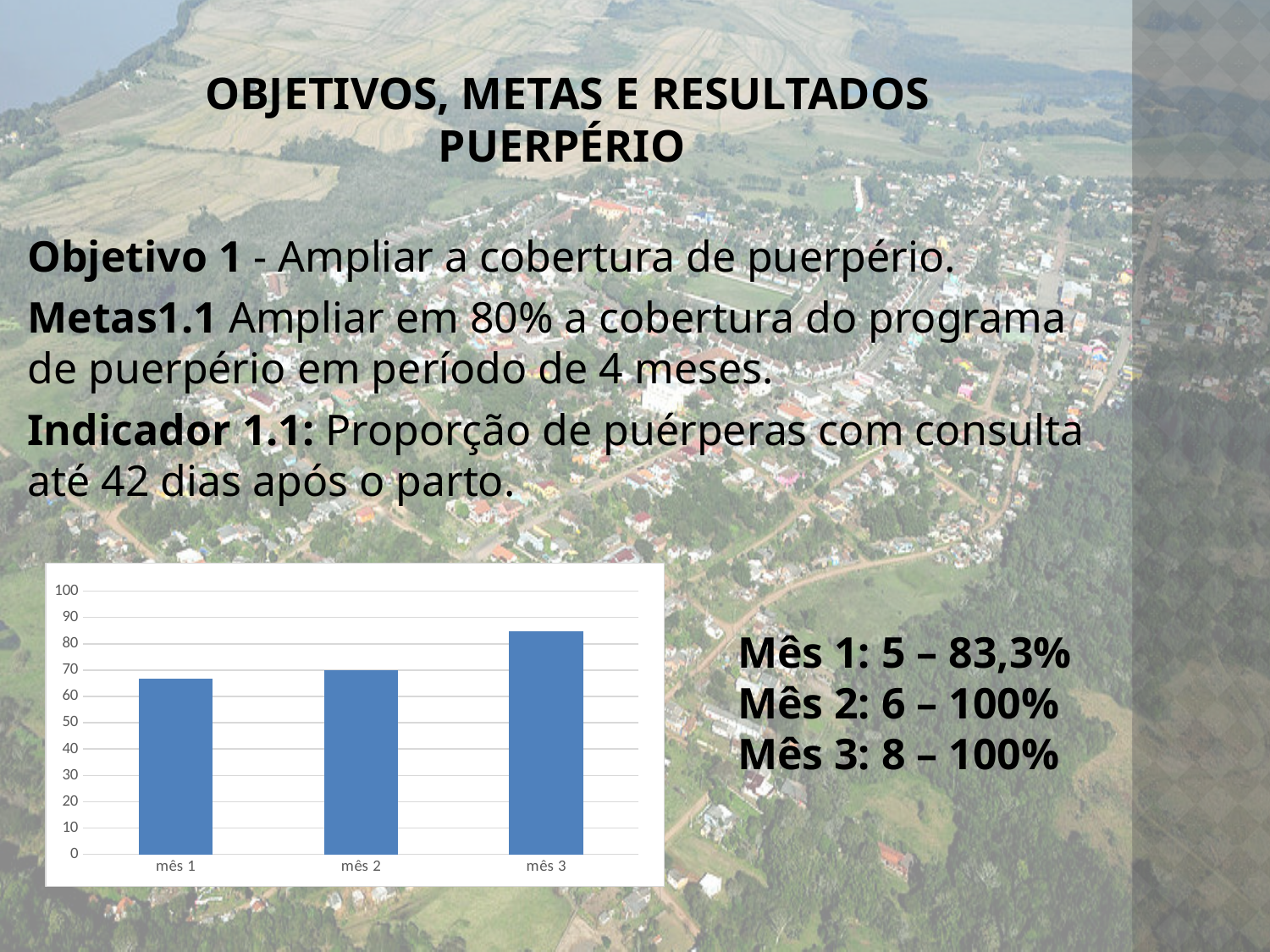
What colour are the bars in the chart? blue Which category has the highest bar in the chart? mês 3 Do the bar values rise or fall from mês 1 to mês 3? rise Which category has the lowest bar in the chart? mês 1 Which is larger, the bar for mês 1 or the bar for mês 3? mês 3 What kind of chart is shown on the slide? bar chart How many categories are plotted on the x axis of the chart? 3 Is the value for mês 1 greater or less than 60? greater Is the value for mês 3 greater or less than 80? greater Is the value for mês 3 greater or less than 90? less What is the maximum value shown on the y axis of the chart? 100